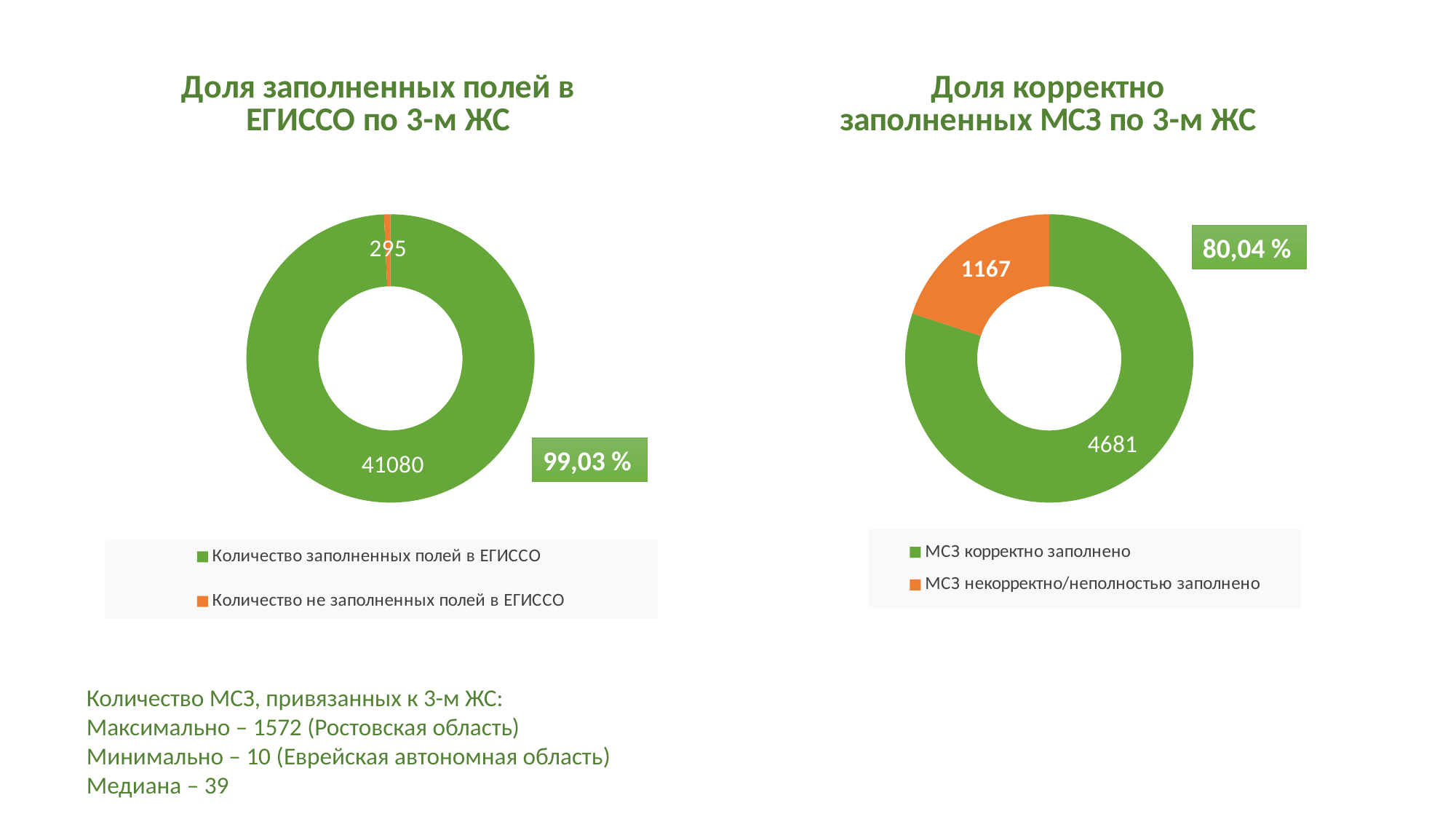
How many entries does the legend of the chart titled "Доля заполненных полей в ЕГИССО по 3-м ЖС" list? 2 In the chart titled "Доля корректно заполненных МСЗ по 3-м ЖС", what share of the chart does the correctly filled slice represent, as labelled on the slide? 80,04 % In the chart titled "Доля заполненных полей в ЕГИССО по 3-м ЖС", what is the value for "Количество заполненных полей в ЕГИССО"? 41080 In the chart titled "Доля заполненных полей в ЕГИССО по 3-м ЖС", which category has the smallest value? Количество не заполненных полей в ЕГИССО In the chart titled "Доля корректно заполненных МСЗ по 3-м ЖС", what is the value for "МСЗ корректно заполнено"? 4681 What kind of chart is the chart titled "Доля корректно заполненных МСЗ по 3-м ЖС"? Doughnut (pie) chart In the chart titled "Доля корректно заполненных МСЗ по 3-м ЖС", what is the value for "МСЗ некорректно/неполностью заполнено"? 1167 In the chart titled "Доля заполненных полей в ЕГИССО по 3-м ЖС", what is the total of the two values shown? 41375 In the chart titled "Доля заполненных полей в ЕГИССО по 3-м ЖС", what is the value for "Количество не заполненных полей в ЕГИССО"? 295 In the chart titled "Доля корректно заполненных МСЗ по 3-м ЖС", which category has the largest value? МСЗ корректно заполнено In the chart titled "Доля заполненных полей в ЕГИССО по 3-м ЖС", what share of the chart does the filled-fields slice represent, as labelled on the slide? 99,03 % In the chart titled "Доля корректно заполненных МСЗ по 3-м ЖС", what is the difference between the values for "МСЗ корректно заполнено" and "МСЗ некорректно/неполностью заполнено"? 3514